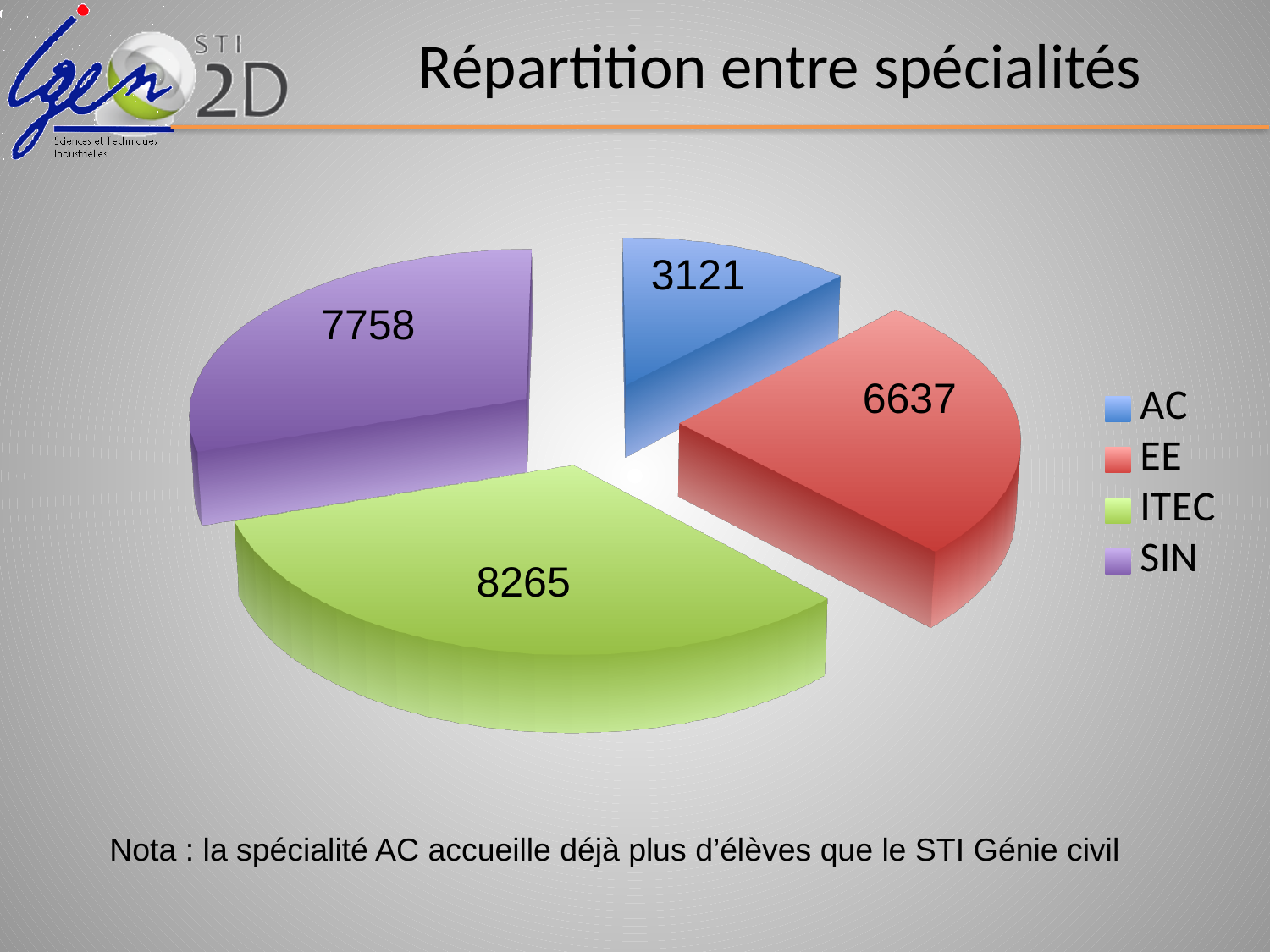
What is the value for EE in the pie chart? 6637 Which specialty has the smallest slice of the pie? AC What type of chart is shown on the slide? pie chart What is the value for SIN in the pie chart? 7758 What is the title of the slide containing the pie chart? Répartition entre spécialités What is the value for AC in the pie chart? 3121 What is the value for ITEC in the pie chart? 8265 What is the difference between the values for ITEC and SIN? 507 How many categories does the pie chart show? 4 Which specialty has the largest slice of the pie? ITEC What is the difference between the values for EE and AC? 3516 Which is larger, the value for SIN or the value for EE? SIN